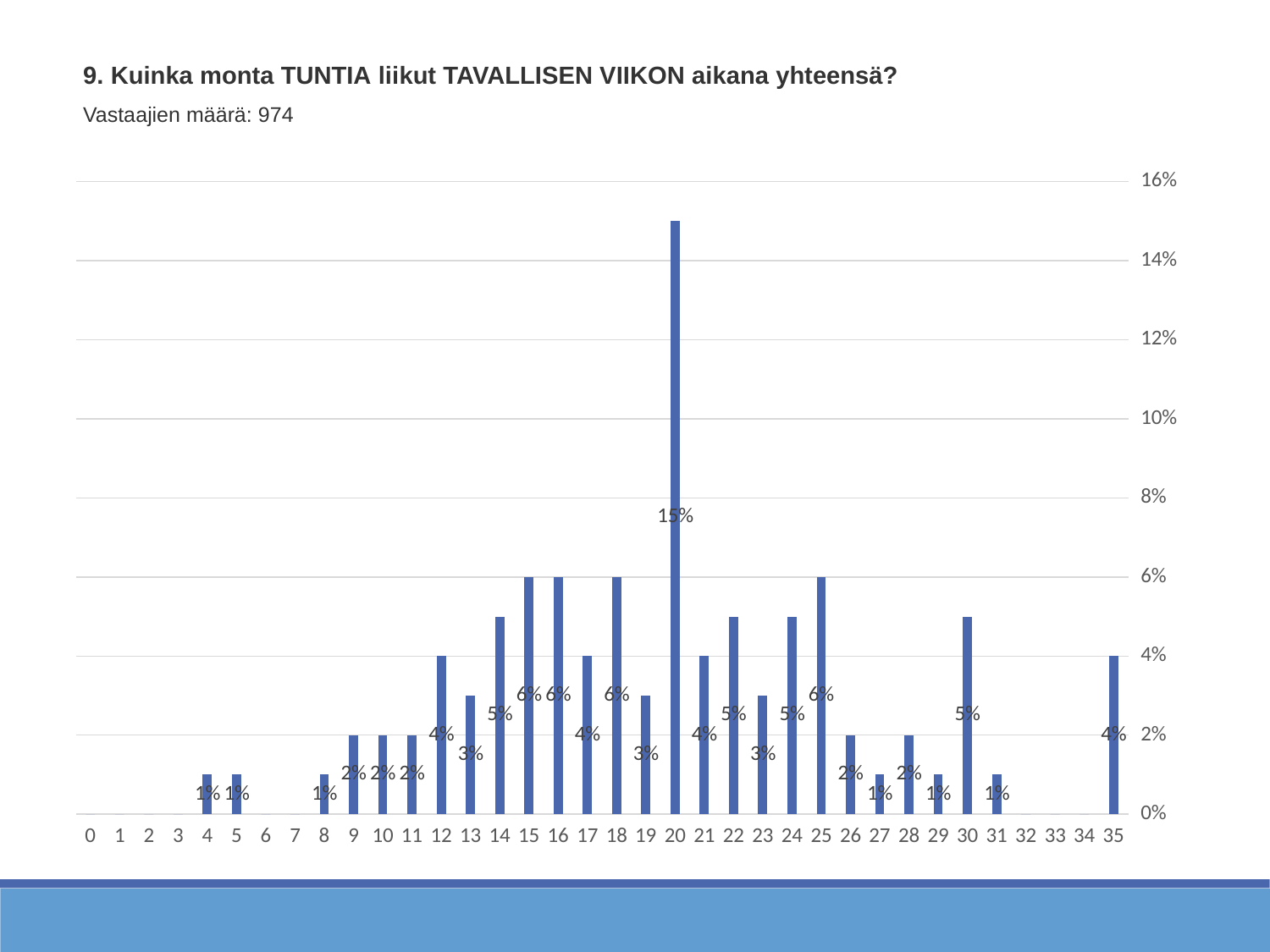
What percentage of respondents reported 20 hours? 15% Is the value for 20 hours greater or less than 10%? greater How many categories are labelled on the x axis? 36 What is the value shown for 12 hours? 4% What is the value shown for 30 hours? 5% Which has a larger value, 14 hours or 13 hours? 14 hours What is the value shown for 35 hours? 4% What is the difference between the value for 25 hours and the value for 26 hours? 4 percentage points Which number of hours has the highest percentage of respondents? 20 What is the difference between the value for 20 hours and the value for 15 hours? 9 percentage points How many respondents does the slide say answered the question? 974 What kind of chart is shown on the slide? bar chart